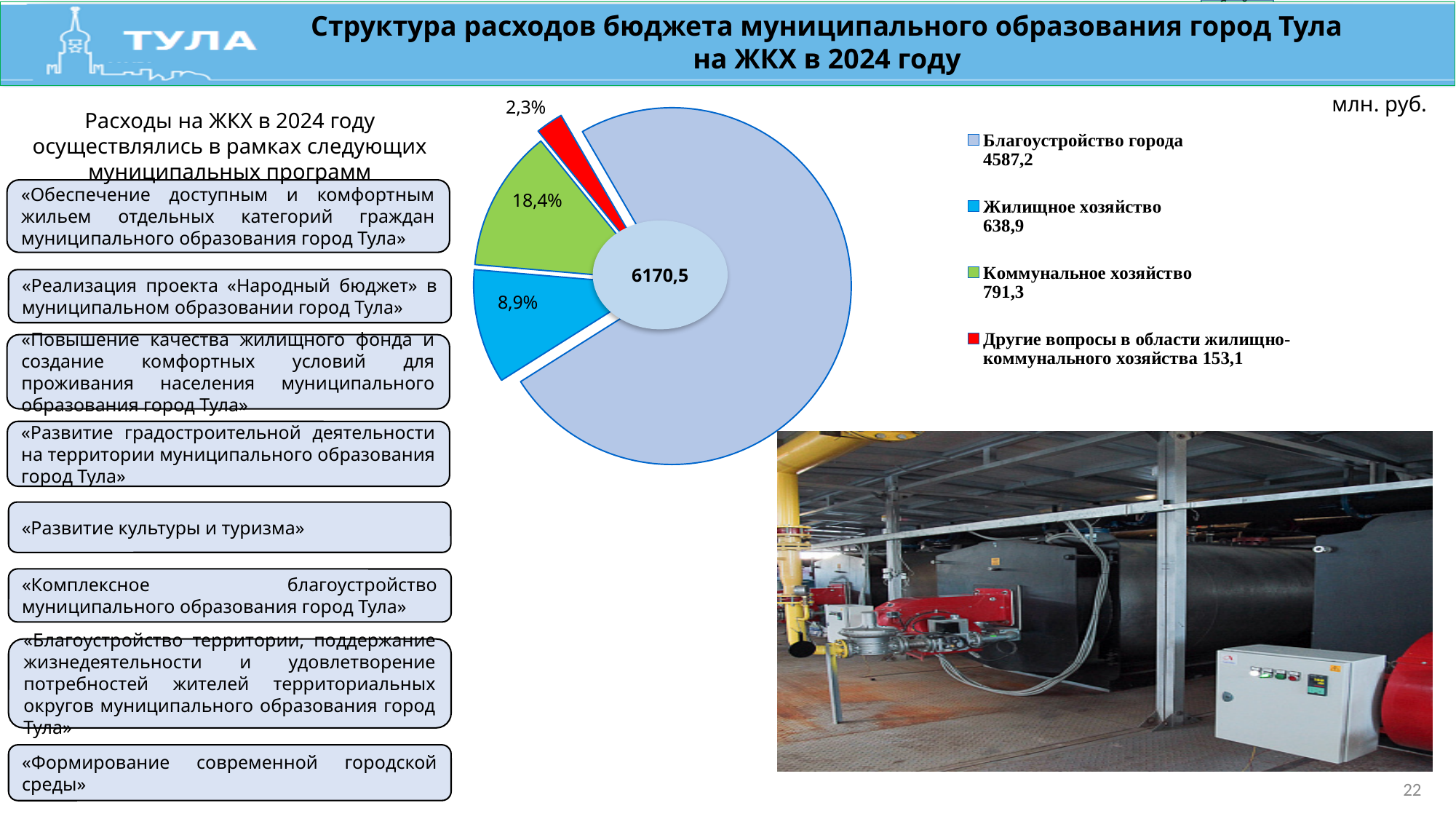
What share of the pie does Коммунальное хозяйство represent? 18,4% What is the value for Коммунальное хозяйство in the pie chart? 791,3 How many categories does the pie chart show? 4 What kind of chart is shown on the slide? pie chart What total value is printed in the centre of the pie chart? 6170,5 What is the value for Другие вопросы в области жилищно-коммунального хозяйства in the pie chart? 153,1 What is the difference between the values for Коммунальное хозяйство and Жилищное хозяйство? 152,4 What is the value for Жилищное хозяйство in the pie chart? 638,9 Which category has the largest share of the pie chart? Благоустройство города What share of the pie does Жилищное хозяйство represent? 8,9% What is the value for Благоустройство города in the pie chart? 4587,2 Which category has the smallest share of the pie chart? Другие вопросы в области жилищно-коммунального хозяйства